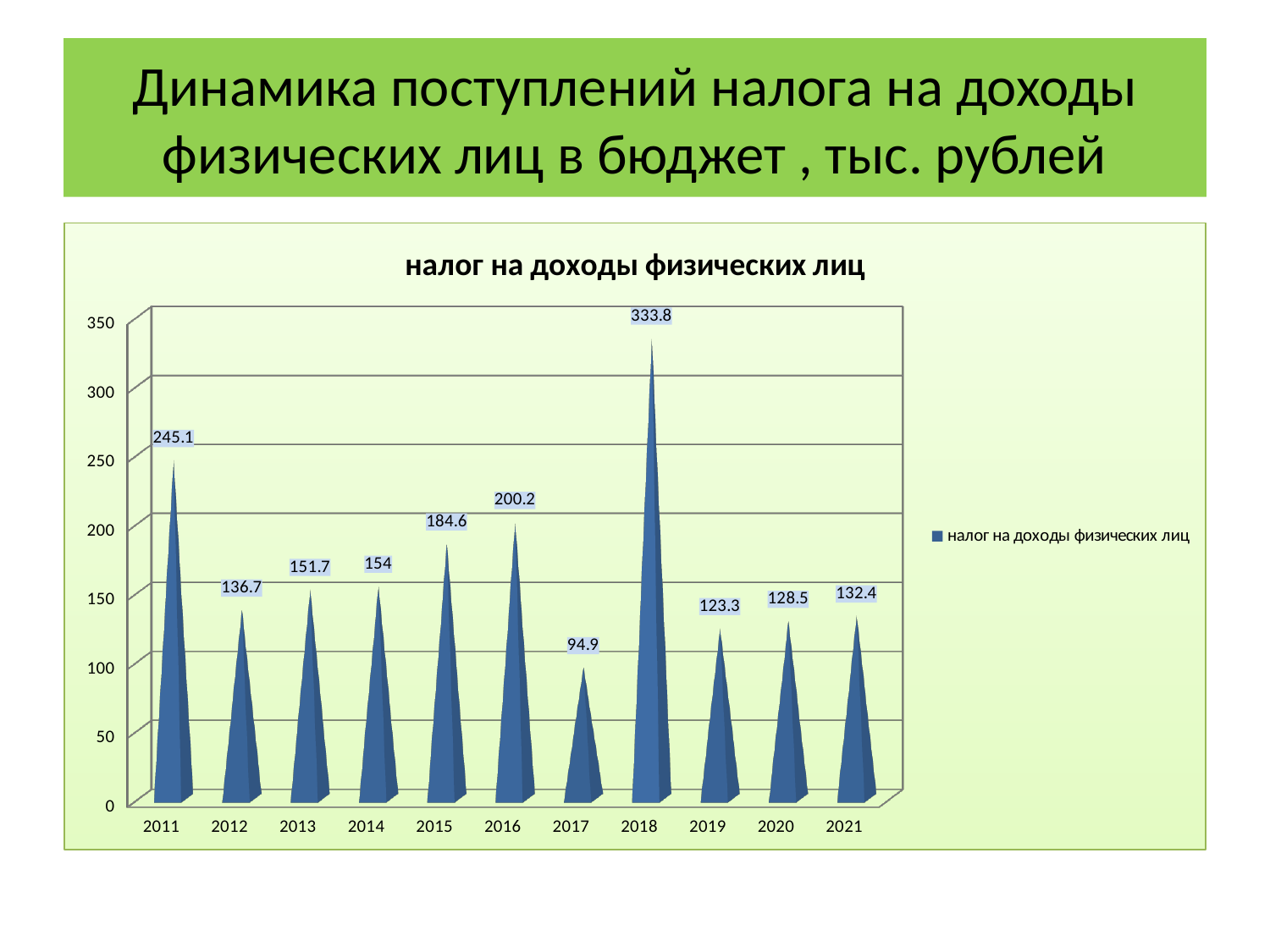
What is the value for 2017? 94.9 What kind of chart is this? bar chart Which is larger, the value for 2015 or the value for 2016? 2016 Which year has the highest value? 2018 What is the value for 2018? 333.8 Which year has the lowest value? 2017 What is the value for 2011? 245.1 Is the value for 2019 greater or less than 150? less How many years are shown on the x axis? 11 What is the difference between the values for 2018 and 2011? 88.7 How many series does the legend list? 1 What is the title of the chart? налог на доходы физических лиц